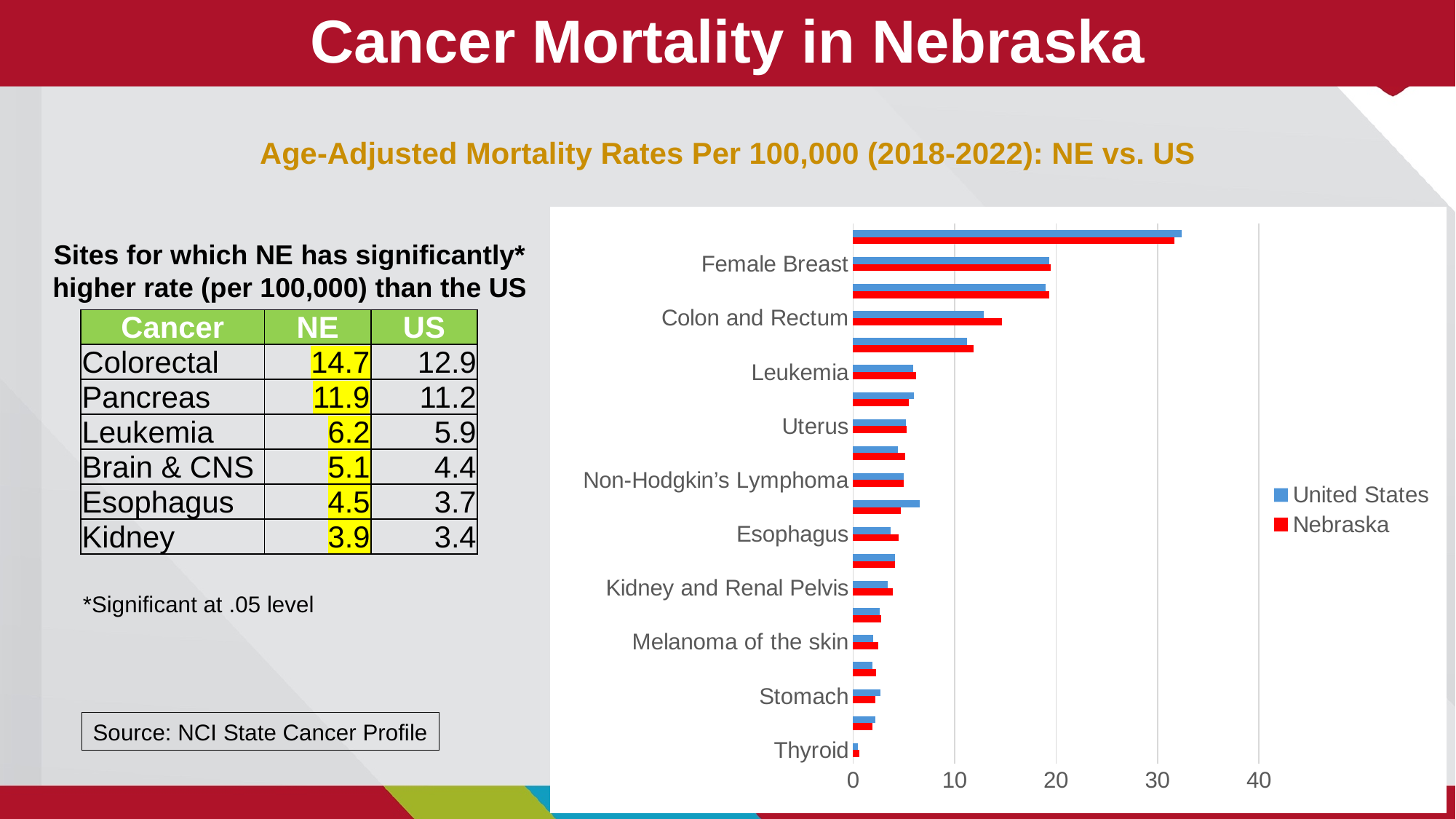
What is the highest tick value shown on the chart's horizontal axis? 40 What kind of chart is shown on the slide? bar chart Is the Nebraska value for Colon and Rectum greater or less than 10? greater Is the Nebraska value for Melanoma of the skin greater or less than 10? less For Colon and Rectum, which is larger: the Nebraska value or the United States value? Nebraska How many series does the chart's legend list? 2 Which colour represents Nebraska in the chart? red Is the United States value for Thyroid greater or less than 10? less Of the categories labeled on the chart's axis, which has the lowest values? Thyroid Which two series are listed in the chart's legend? United States and Nebraska